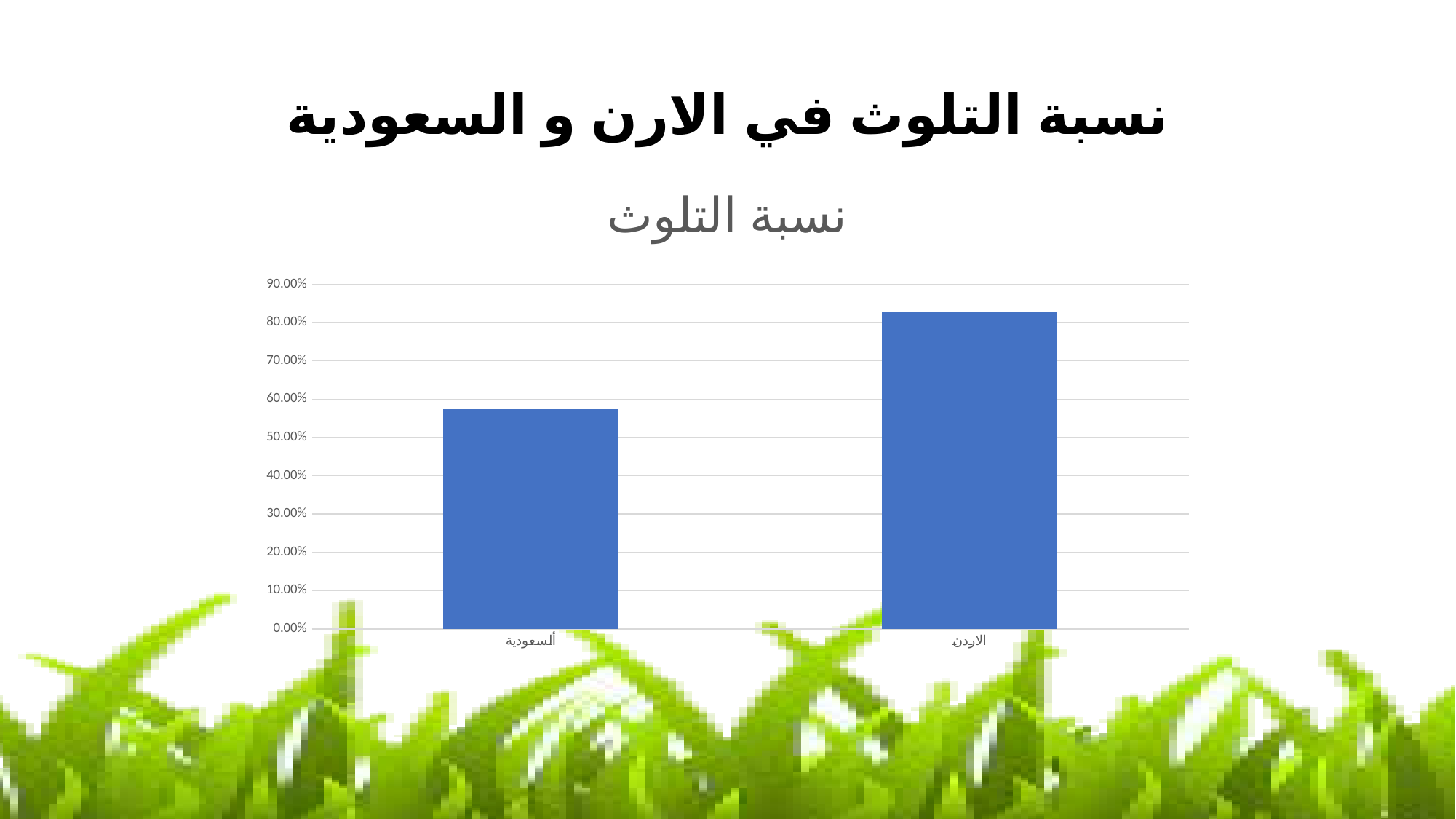
Which is larger, the value for السعودية or the value for الاردن? الاردن Is the value for الاردن greater or less than 90.00%? less How many categories are plotted in the chart? 2 Is the value for السعودية greater or less than 50.00%? greater Which category has the highest value in the chart? الاردن Is the value for الاردن greater or less than 80.00%? greater What is the title of the chart? نسبة التلوث What kind of chart is shown on the slide? bar chart Which category has the lowest value in the chart? ألسعودية What is the highest value shown on the vertical axis of the chart? 90.00%